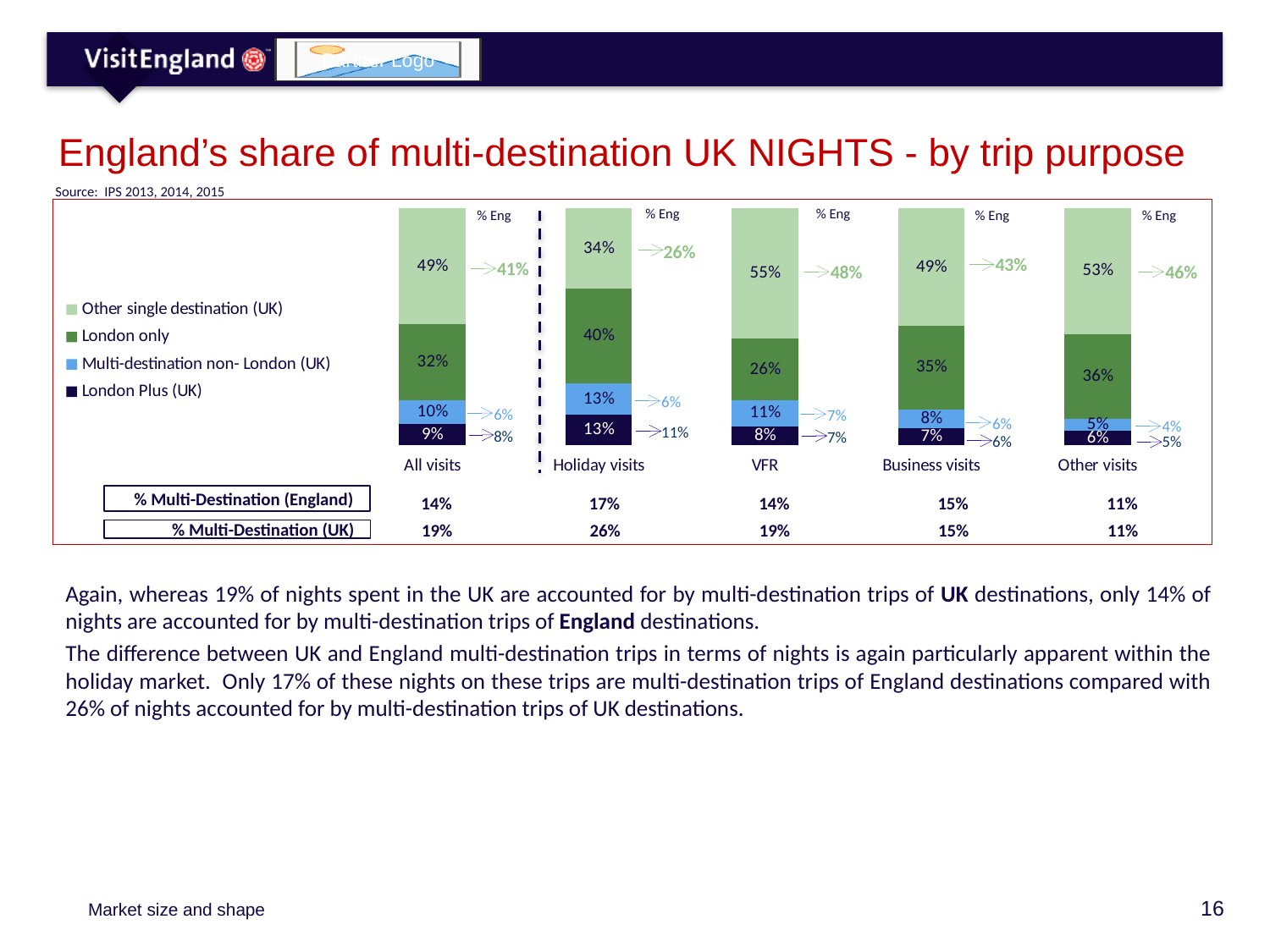
Which trip purpose has the highest 'Other single destination (UK)' share? VFR What is the value for 'London only' in the Holiday visits bar? 40% How many series does the chart legend list? 4 What is the '% Multi-Destination (UK)' figure shown for Holiday visits? 26% What is the value for 'Multi-destination non- London (UK)' in the Business visits bar? 8% What kind of chart is shown on the slide? Stacked bar chart What is the value for 'Other single destination (UK)' in the VFR bar? 55% How many trip purpose categories are plotted in the chart? 5 What is the value for 'London Plus (UK)' in the All visits bar? 9% Which trip purpose has the lowest 'Multi-destination non- London (UK)' share? Other visits Which is larger: the 'London Plus (UK)' value for Holiday visits or for Other visits? Holiday visits What is the difference between the 'London only' values for Holiday visits and VFR? 14%